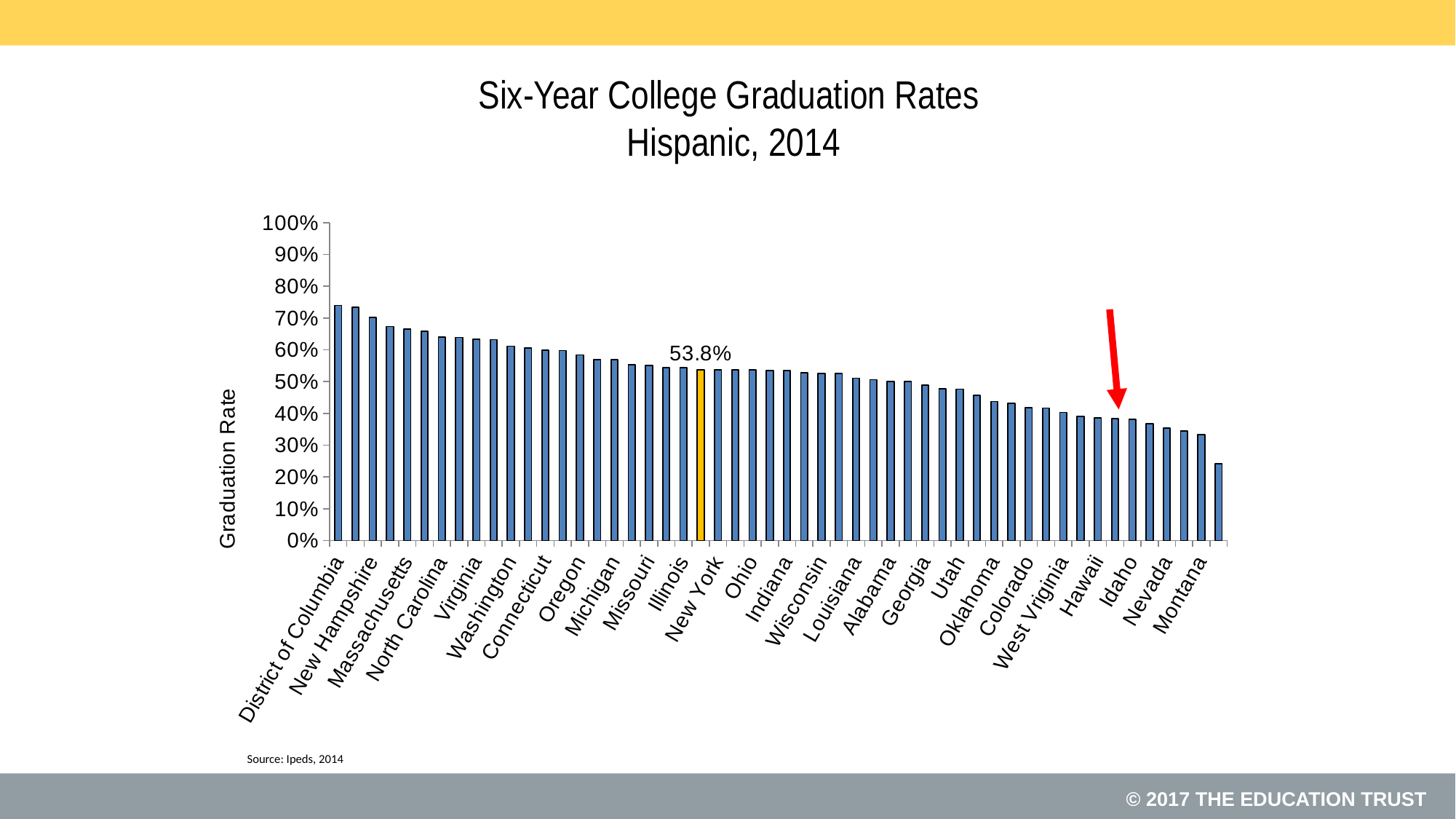
What is the title of the chart? Six-Year College Graduation Rates Hispanic, 2014 Do the graduation rates rise or fall moving from left to right across the chart? fall Is the value for District of Columbia greater or less than 70%? greater What kind of chart is shown on the slide? bar chart Which state has the highest Hispanic six-year graduation rate? District of Columbia Which has a higher graduation rate, Virginia or Utah? Virginia Is the value for Oklahoma greater or less than 50%? less Is the value for Montana greater or less than 30%? greater What is the label on the vertical axis? Graduation Rate